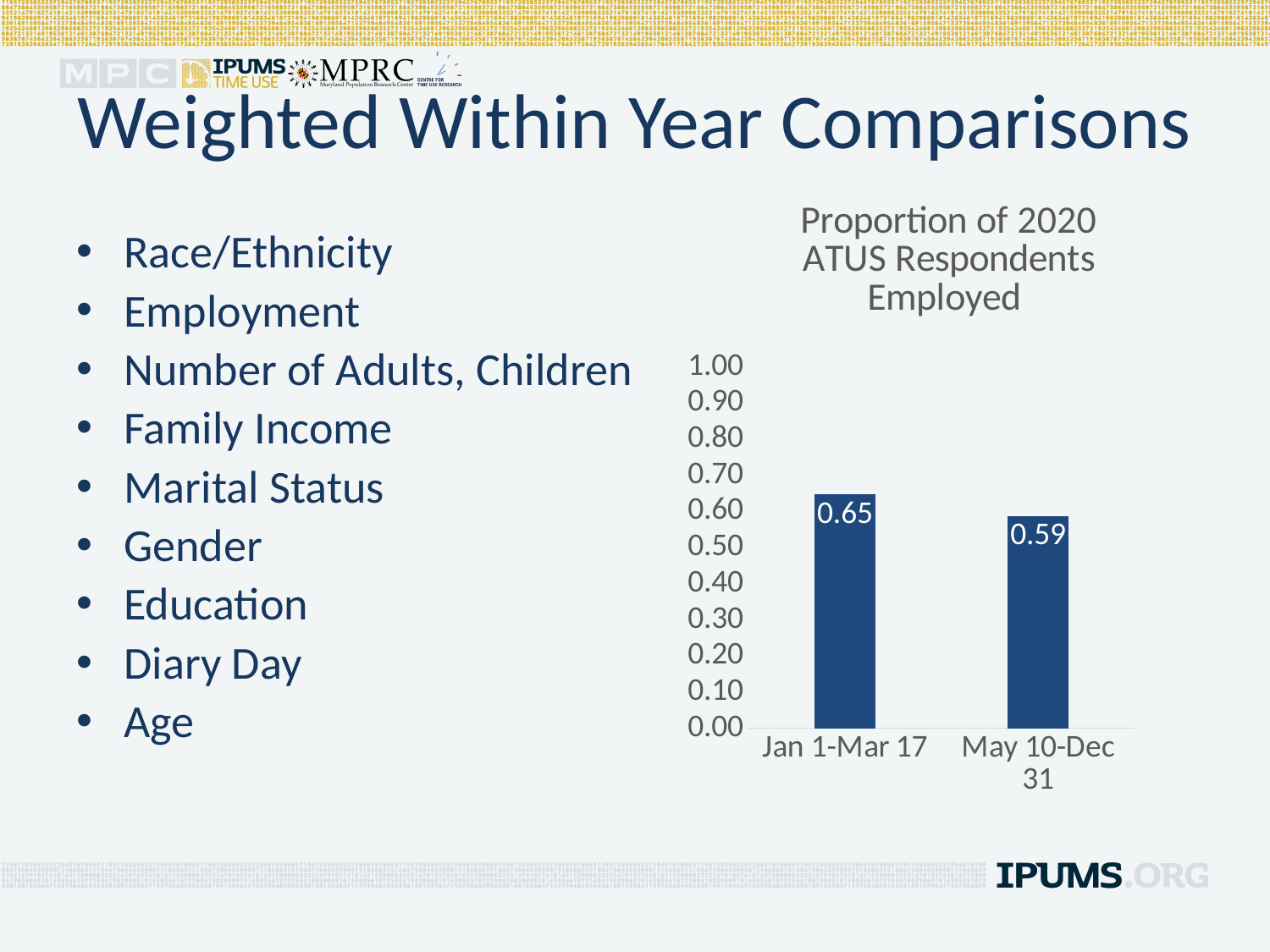
Do the values rise or fall from Jan 1-Mar 17 to May 10-Dec 31? fall Is the value for Jan 1-Mar 17 larger or smaller than the value for May 10-Dec 31? larger Is the value for Jan 1-Mar 17 greater or less than 0.50? greater What kind of chart is shown on the slide? bar chart Which period has the lower proportion of employed respondents? May 10-Dec 31 What is the value for Jan 1-Mar 17? 0.65 What is the title of the chart? Proportion of 2020 ATUS Respondents Employed Which period has the higher proportion of employed respondents? Jan 1-Mar 17 What is the value for May 10-Dec 31? 0.59 What is the difference between the values for Jan 1-Mar 17 and May 10-Dec 31? 0.06 Is the value for May 10-Dec 31 greater or less than 0.70? less How many categories are shown on the x axis? 2